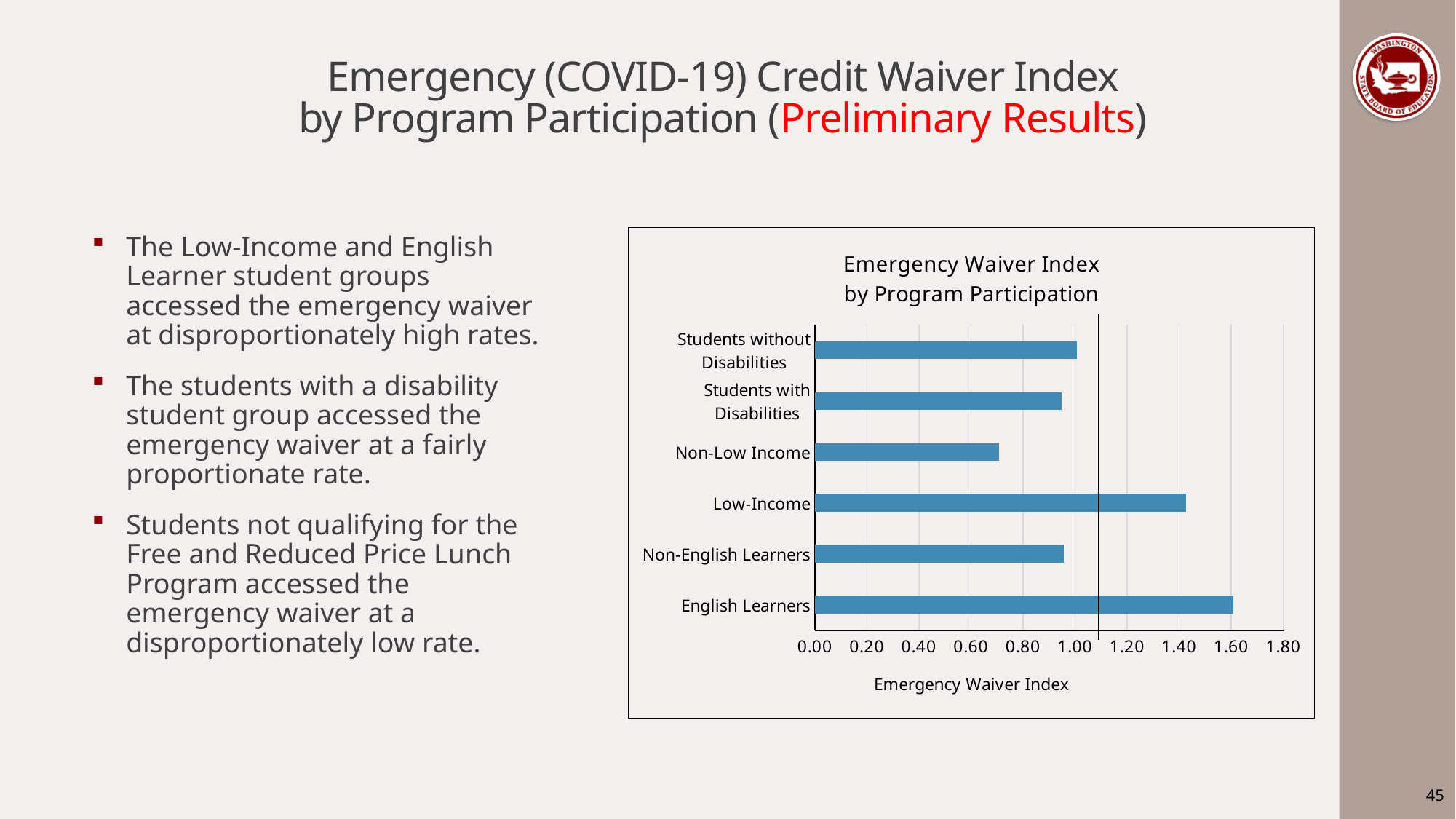
Which category has the highest Emergency Waiver Index? English Learners Which category has the lowest Emergency Waiver Index? Non-Low Income What is the title of the chart? Emergency Waiver Index by Program Participation Is the value for Low-Income greater or less than 1.20? greater How many program participation categories are plotted in the chart? 6 Is the value for English Learners greater or less than 1.40? greater Which has a higher Emergency Waiver Index, English Learners or Low-Income? English Learners Which has a higher Emergency Waiver Index, Low-Income or Non-Low Income? Low-Income What is the label on the horizontal axis of the chart? Emergency Waiver Index Is the value for Non-English Learners greater or less than 1.20? less What kind of chart is shown on the slide? bar chart